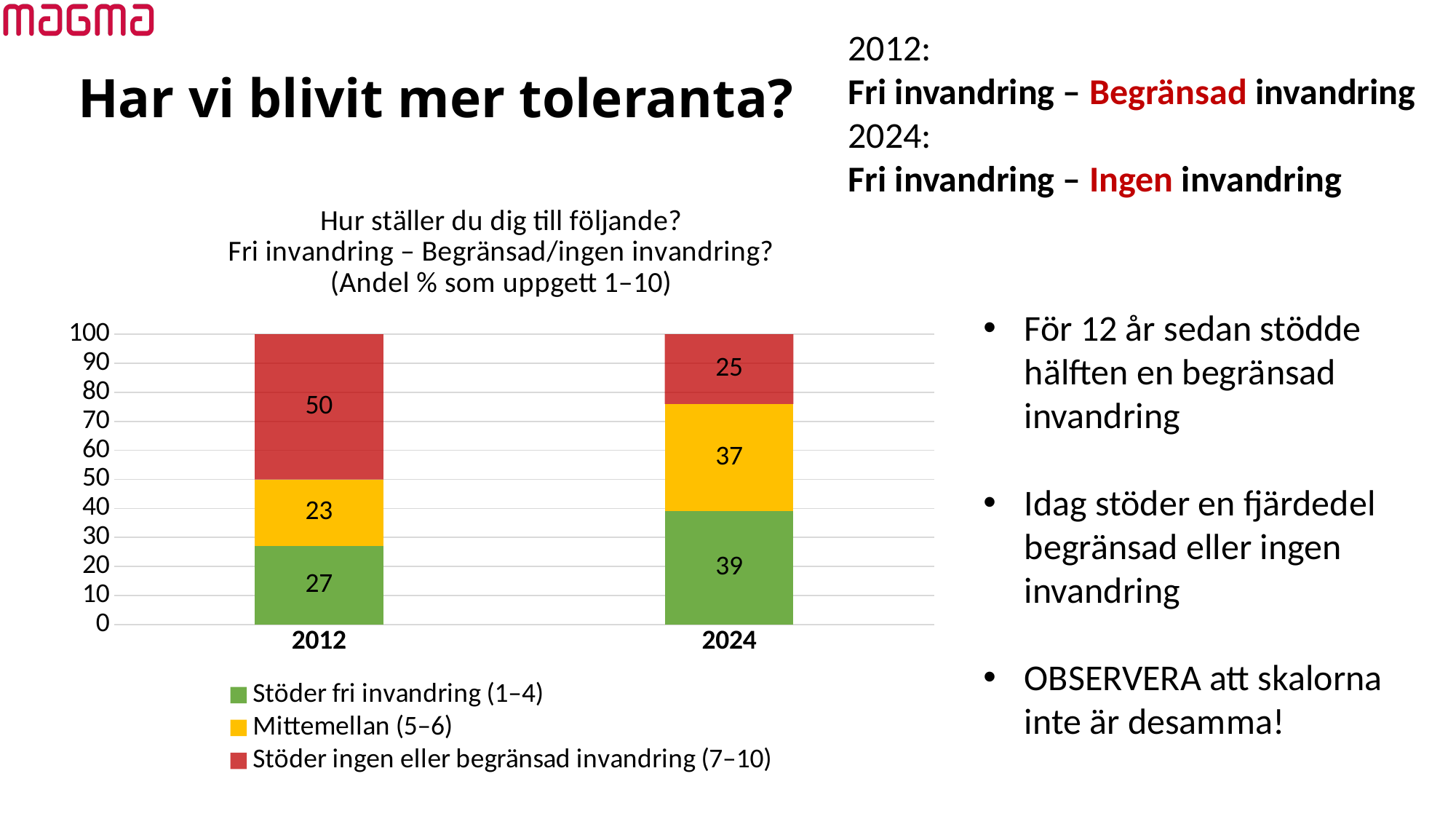
What is the value for "Stöder ingen eller begränsad invandring (7–10)" in 2012? 50 How many categories are shown on the x axis? 2 What is the value for "Stöder ingen eller begränsad invandring (7–10)" in 2024? 25 What is the total of the stacked bar for 2012? 100 What kind of chart is shown on the slide? Stacked bar chart Which colour represents "Mittemellan (5–6)" in the chart? Yellow What is the difference between the "Stöder ingen eller begränsad invandring (7–10)" values for 2012 and 2024? 25 What is the value for "Mittemellan (5–6)" in 2024? 37 Which year has the higher value for "Stöder fri invandring (1–4)"? 2024 What is the value for "Stöder fri invandring (1–4)" in 2012? 27 How many series does the legend list? 3 What is the difference between the "Mittemellan (5–6)" values for 2024 and 2012? 14